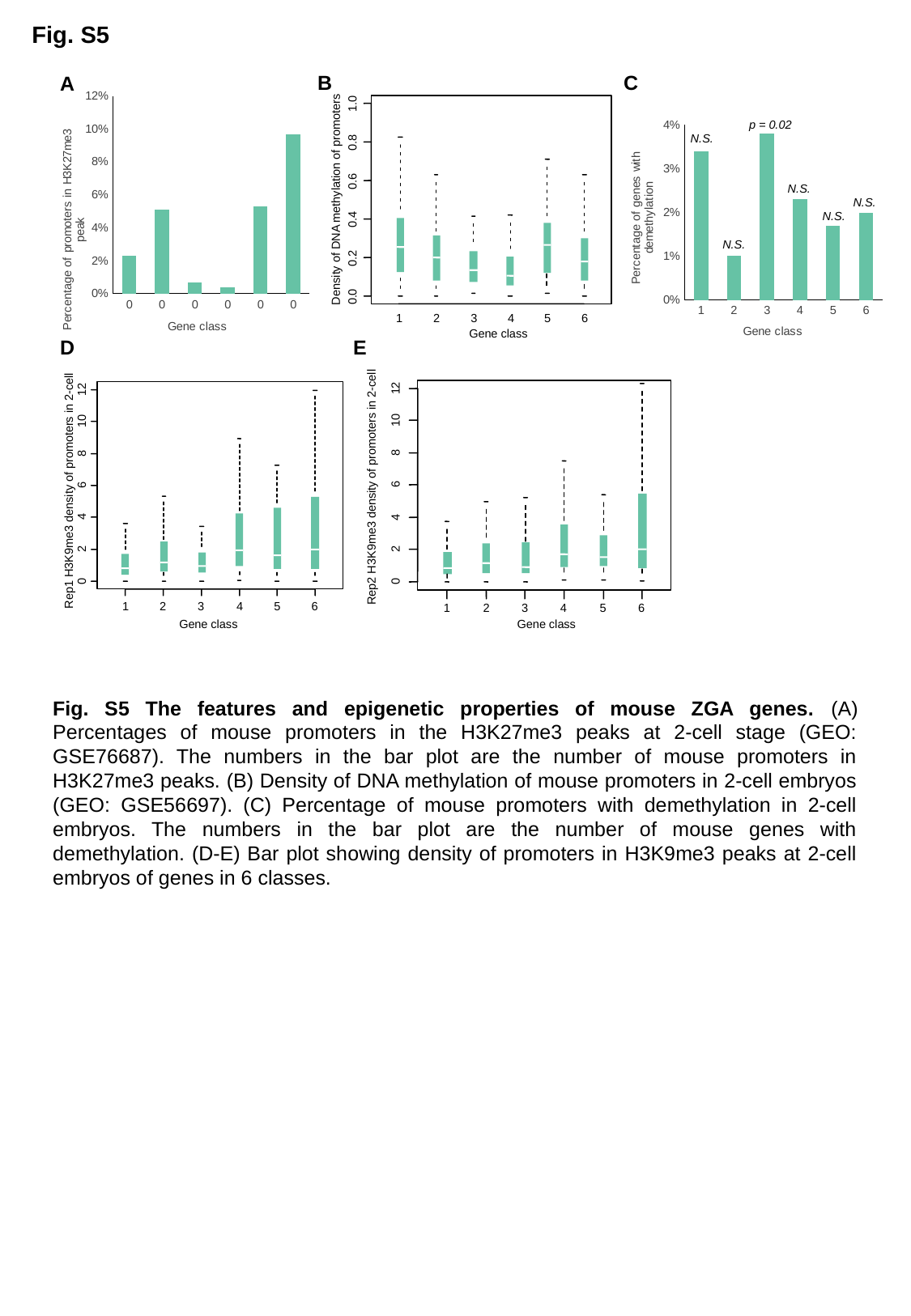
In panel A, is the value of the rightmost bar greater or less than 8%? greater In panel C, which has a higher percentage of genes with demethylation, gene class 1 or gene class 4? gene class 1 In panel C, which gene class has the highest percentage of genes with demethylation? 3 In panel A, what kind of chart is shown? bar chart In panel B, how many gene classes are shown on the x axis? 6 In panel C, is the value for gene class 5 greater or less than 2%? less In panel A, is the value of the second bar from the left greater or less than 4%? greater In panel C, which gene class has the lowest percentage of genes with demethylation? 2 In panel C, which gene class is annotated with p = 0.02? 3 In panel A, how many bars are plotted? 6 In panel A, which bar is the tallest? the sixth (rightmost) bar